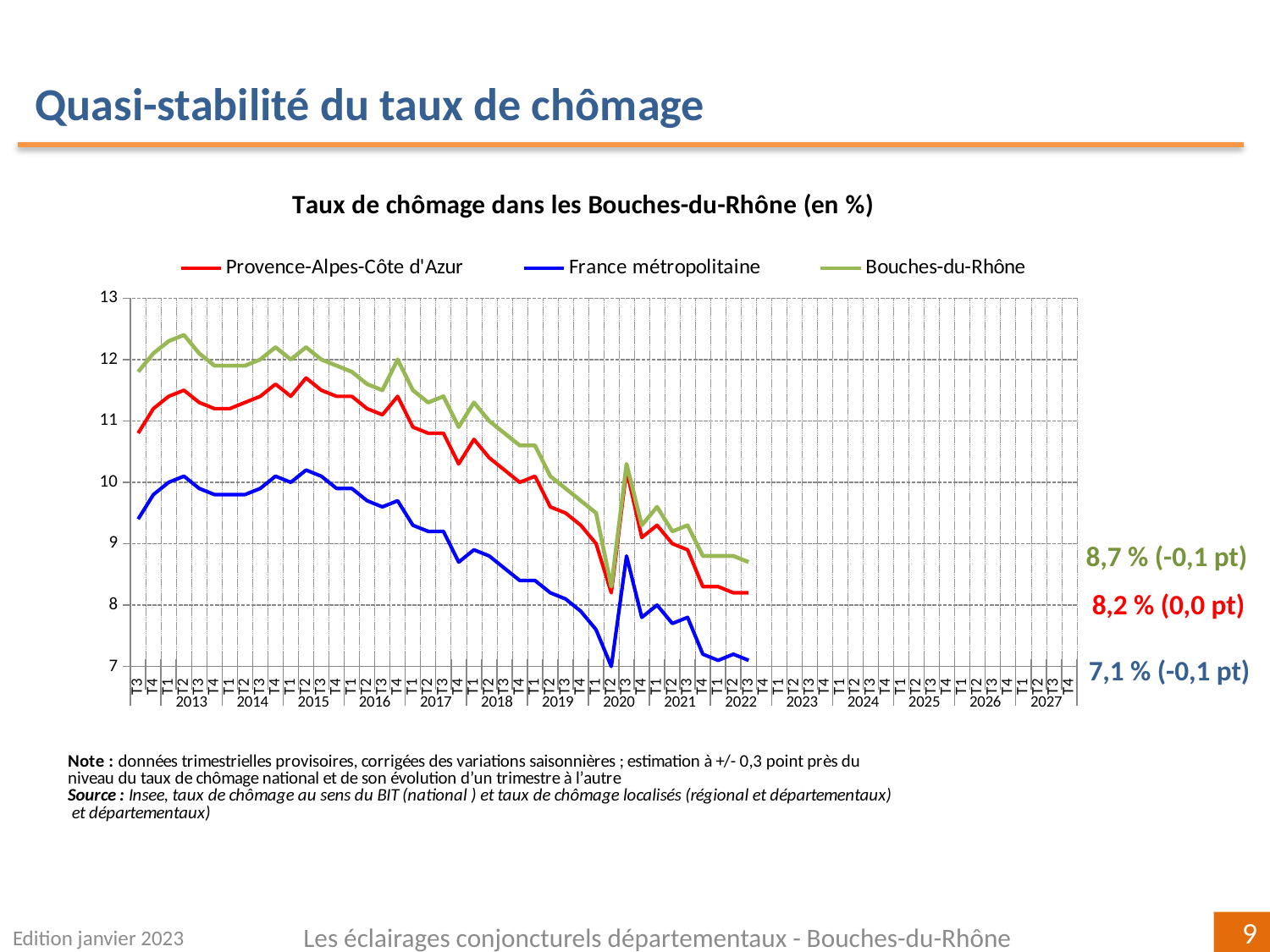
Which series has the lowest value at the end of the period? France métropolitaine What is the latest unemployment rate shown for France métropolitaine? 7,1 % Is the value for Bouches-du-Rhône in T2 2013 greater or less than 12? greater What is the difference between the latest rates for Bouches-du-Rhône (8,7 %) and France métropolitaine (7,1 %)? 1,6 points What is the latest unemployment rate shown for Provence-Alpes-Côte d'Azur? 8,2 % Overall, do the unemployment rates rise or fall between 2013 and 2022? Fall What is the latest unemployment rate shown for Bouches-du-Rhône? 8,7 % Which series has the highest value at the end of the period? Bouches-du-Rhône What is the title of the chart? Taux de chômage dans les Bouches-du-Rhône (en %) How many series does the legend list? 3 What kind of chart is shown on the slide? Line chart Is the value for France métropolitaine in T3 2012 greater or less than 9? greater